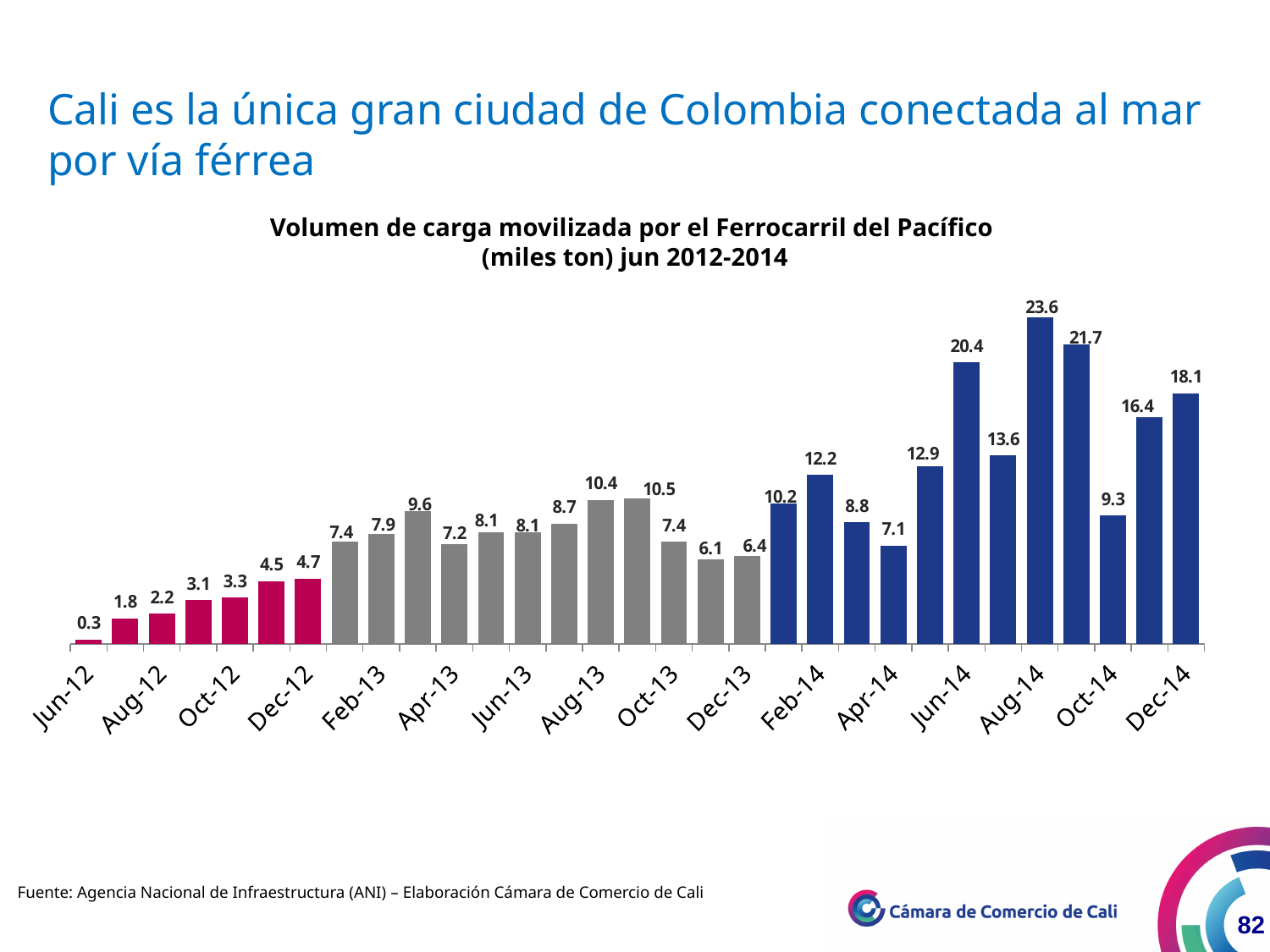
Which month has the highest cargo volume? Aug-14 What is the difference between the cargo volume for Dec-14 and Dec-13? 11.7 How many bars are plotted in the chart? 31 Which month has the lowest cargo volume? Jun-12 What type of chart is shown on the slide? Bar chart What is the cargo volume for Dec-14? 18.1 What is the title of the chart? Volumen de carga movilizada por el Ferrocarril del Pacífico (miles ton) jun 2012-2014 Which is larger, the cargo volume for Jun-14 or Oct-14? Jun-14 What is the cargo volume for Dec-12? 4.7 What is the cargo volume for Jun-13? 8.1 What is the cargo volume for Aug-14? 23.6 Overall, do the cargo volumes rise or fall from Jun-12 to Dec-14? Rise